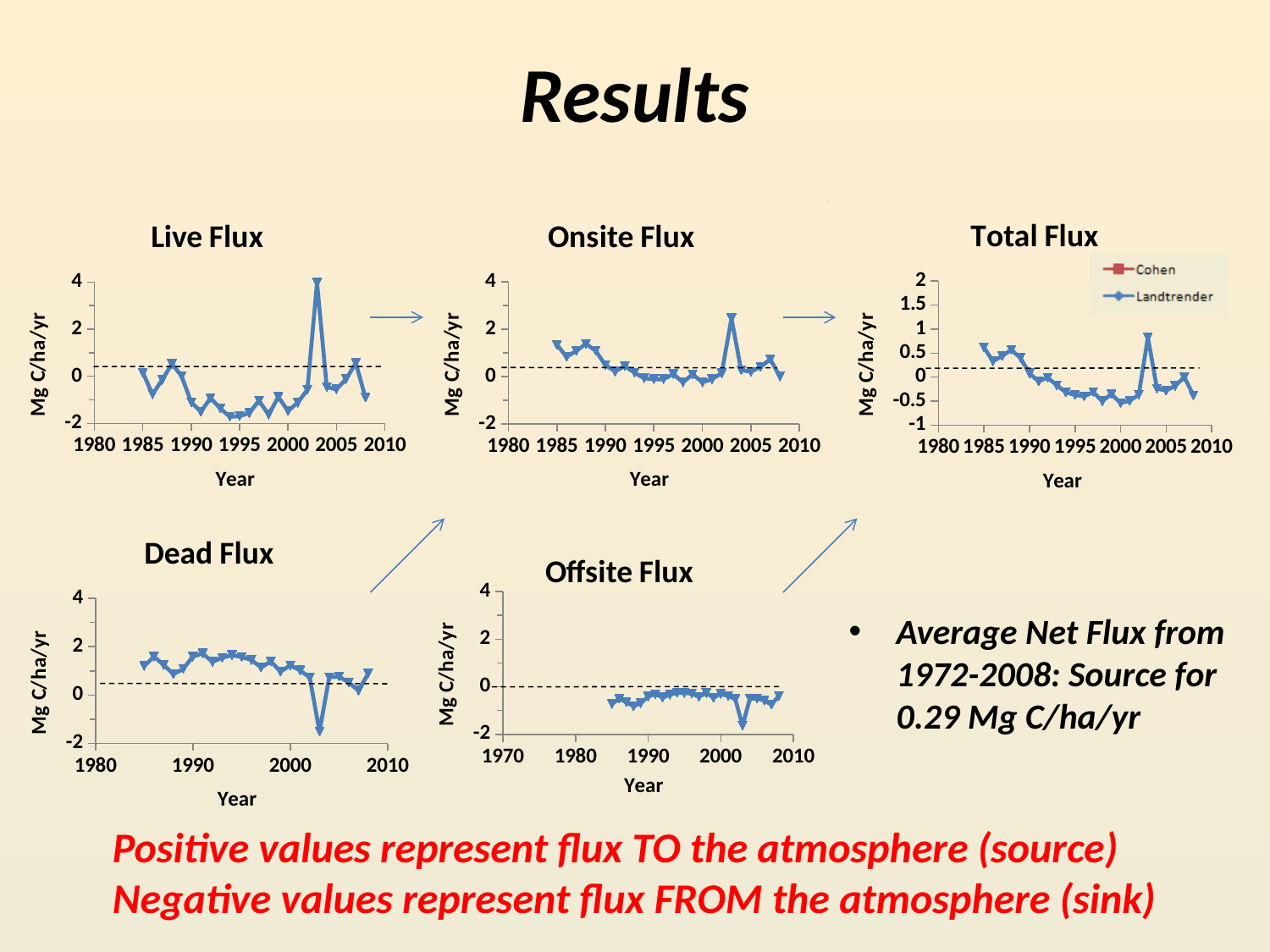
In the Total Flux chart, is the peak value around 2003 greater or less than 0.5? greater What is the y-axis label on the Dead Flux chart? Mg C/ha/yr In the Offsite Flux chart, is the value around 1990 greater or less than 0? less In the Total Flux chart, is the value around 2000 greater or less than 0? less What kind of chart is the Live Flux chart? line chart How many series does the legend on the Total Flux chart list? 2 How many charts are shown on the slide? 5 What are the two series named in the legend of the Total Flux chart? Cohen and Landtrender